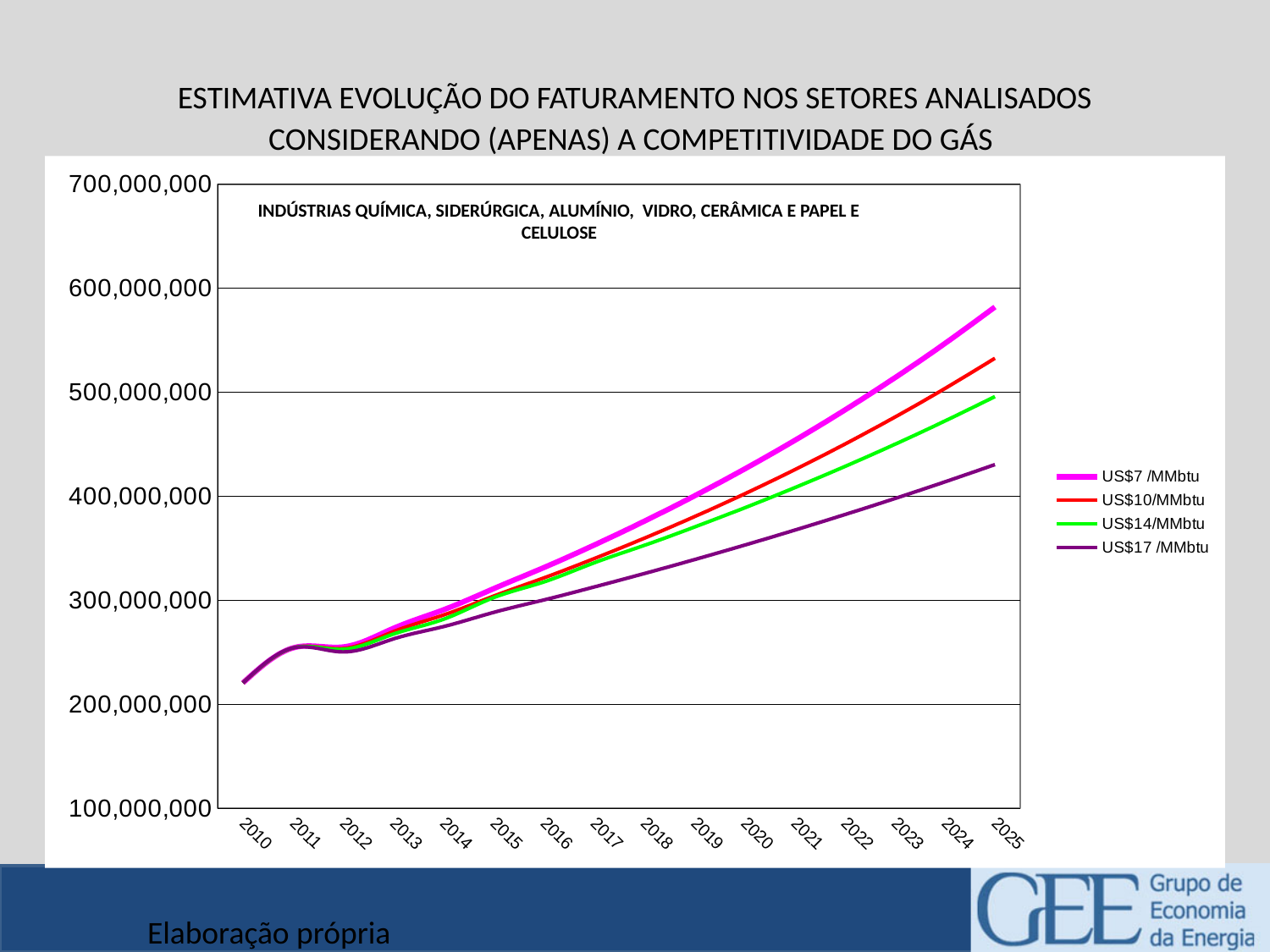
Is the value for US$17 /MMbtu in 2025 greater or less than 500,000,000? less Which series has the lowest value in 2025? US$17 /MMbtu Is the value for US$7 /MMbtu in 2025 greater or less than 500,000,000? greater Do the values of the US$7 /MMbtu series rise or fall from 2010 to 2025? rise What colour is the line for the US$7 /MMbtu series? magenta In 2025, which is larger: the value for US$7 /MMbtu or the value for US$17 /MMbtu? US$7 /MMbtu How many years are shown along the x axis? 16 How many series does the legend list? 4 What kind of chart is shown on the slide? line chart Is the value for US$14/MMbtu in 2025 greater or less than 400,000,000? greater Which series has the highest value in 2025? US$7 /MMbtu